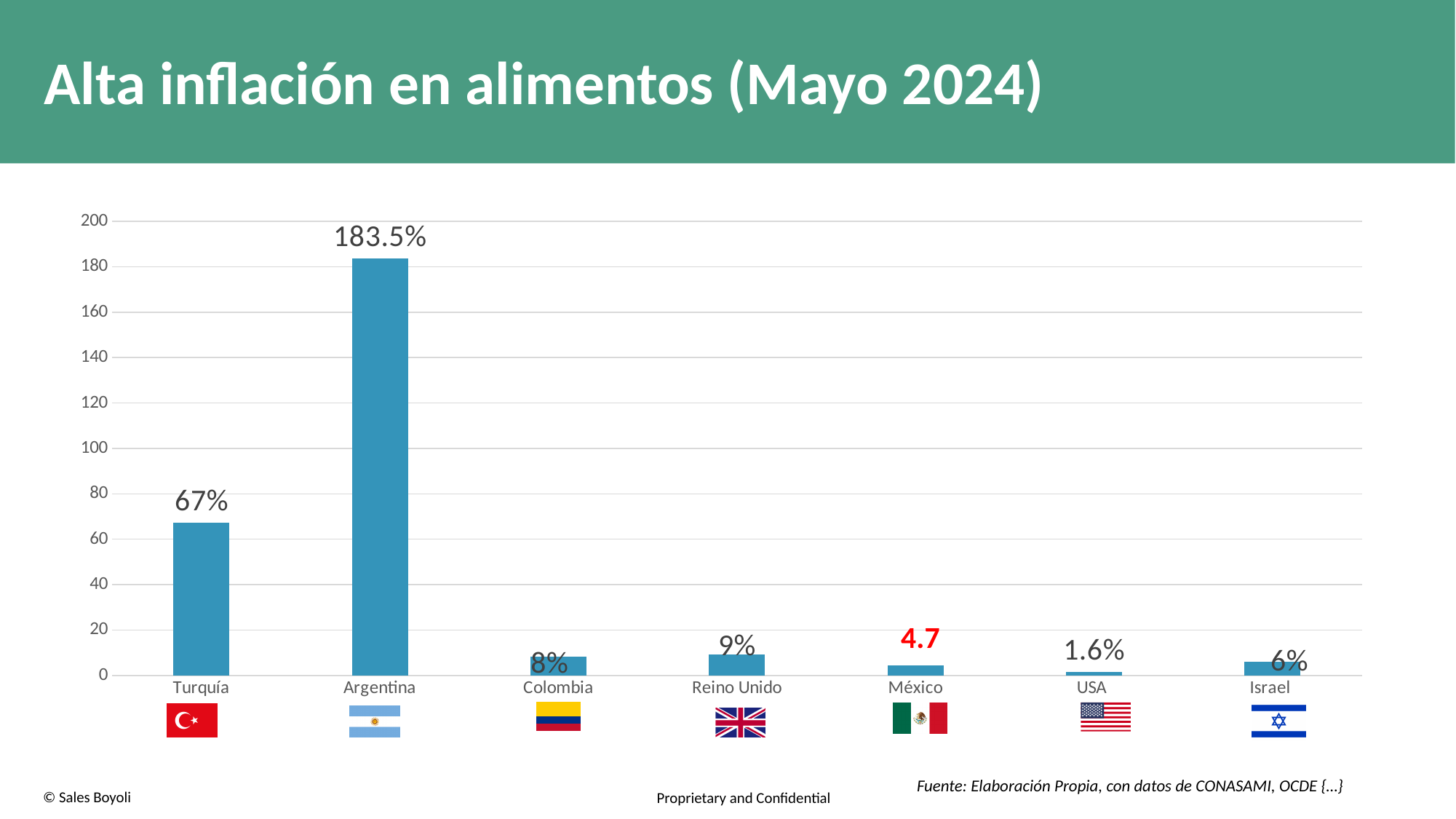
Is the value for Turquía greater or less than 60? greater Which has a higher value, Colombia or Reino Unido? Reino Unido How many countries are shown in the chart? 7 What value is shown for USA? 1.6% What is the food inflation value shown for Argentina? 183.5% What value is shown for Turquía? 67% What type of chart is shown on the slide? Bar chart What is the title of the slide? Alta inflación en alimentos (Mayo 2024) Which country has the highest food inflation in the chart? Argentina What is the difference between the values for Argentina and Turquía? 116.5% Which country has the lowest food inflation in the chart? USA What value is shown for México? 4.7